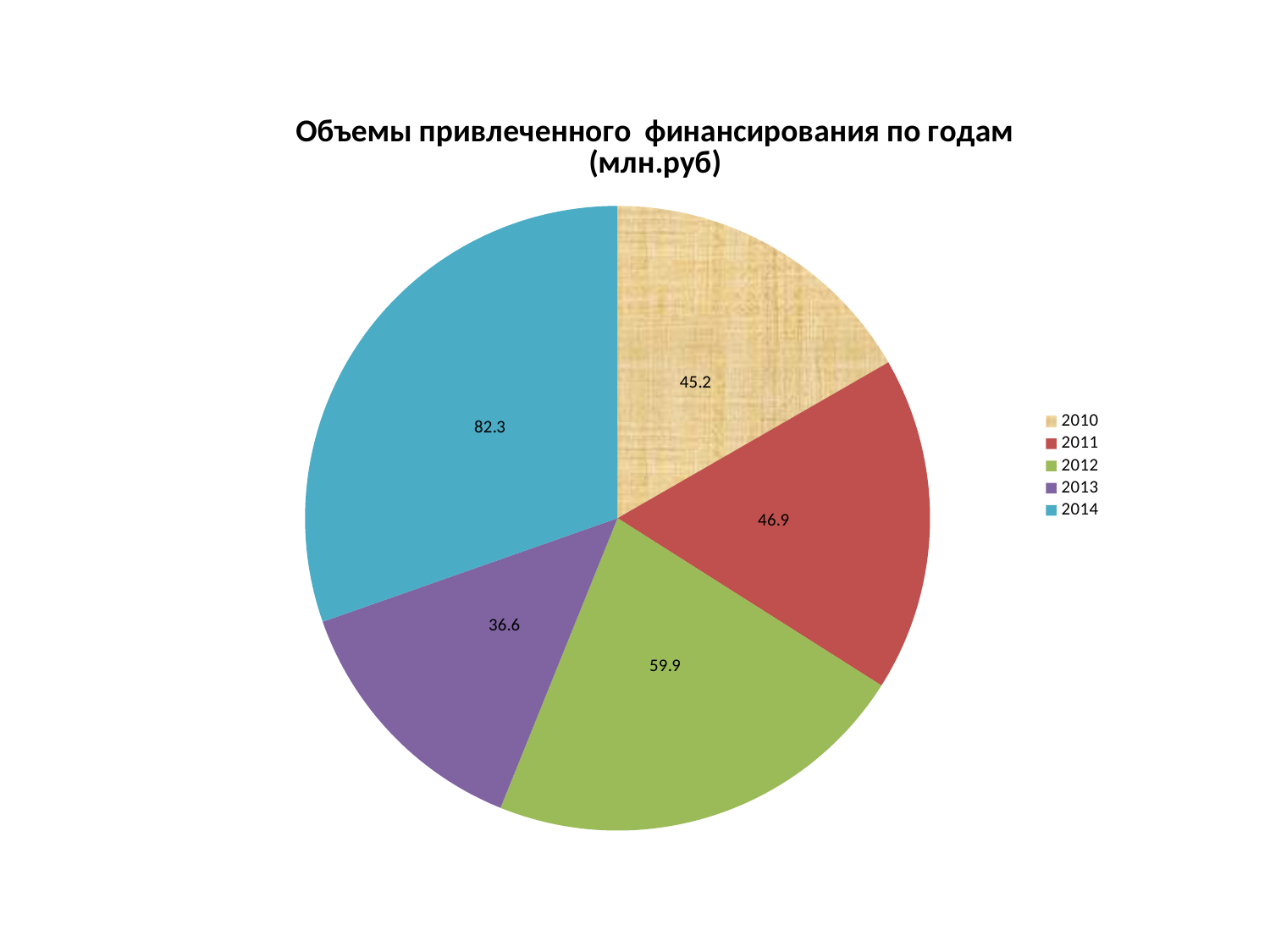
What is the value for 2012 in the pie chart? 59.9 What is the total of all the slices in the pie chart? 270.9 What kind of chart is shown on the slide? Pie chart Which year has the largest slice of the pie? 2014 What is the value for 2013 in the pie chart? 36.6 What is the value for 2014 in the pie chart? 82.3 How many years (slices) are shown in the pie chart? 5 What is the title of the chart? Объемы привлеченного финансирования по годам (млн.руб) Which is larger, the value for 2011 or the value for 2010? 2011 Which year has the smallest slice of the pie? 2013 What is the difference between the values for 2014 and 2013? 45.7 What is the value for 2010 in the pie chart? 45.2